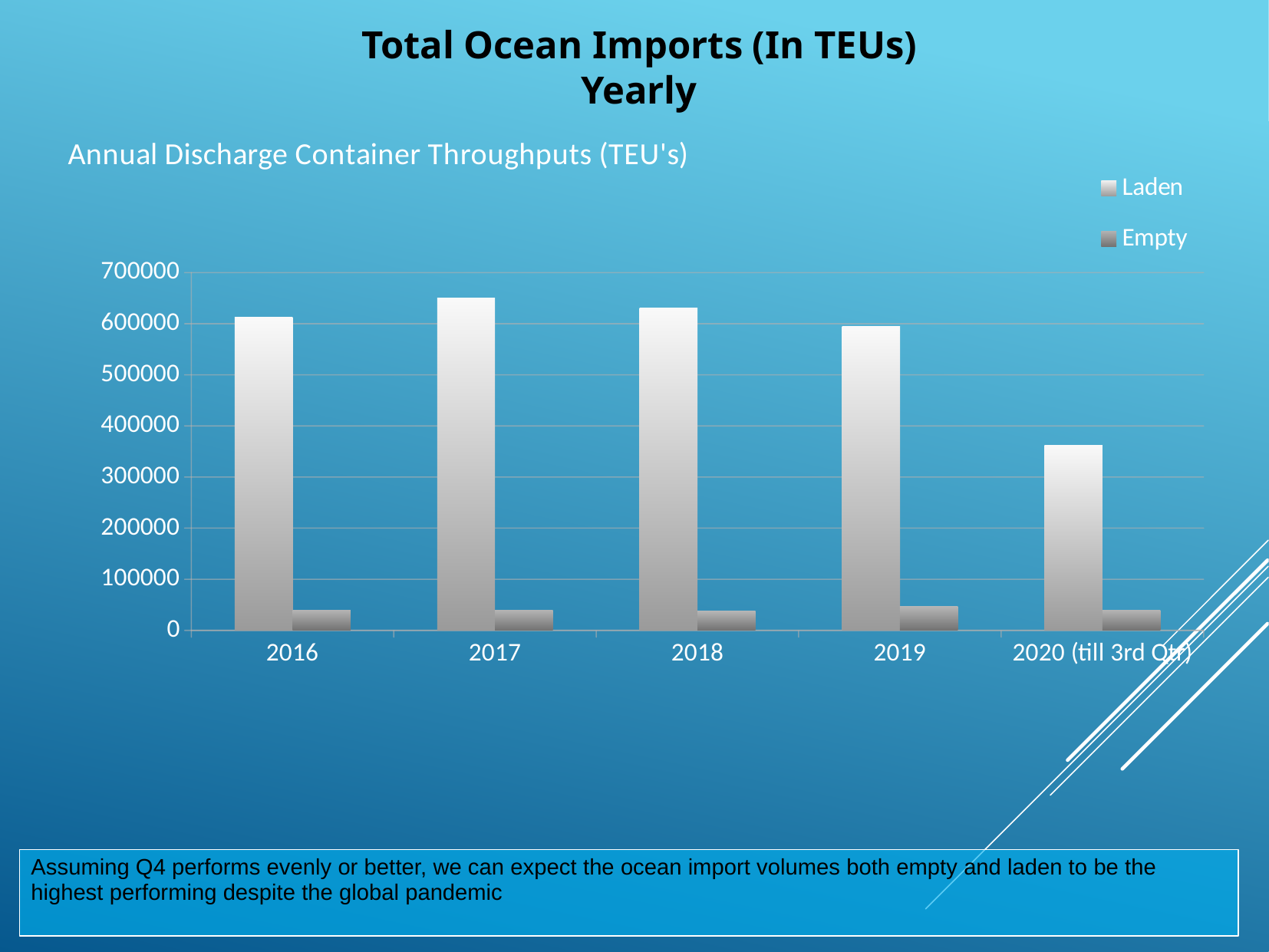
What kind of chart is shown on the slide? bar chart Which year has the highest Empty value? 2019 Is the Empty value for 2019 greater or less than 100000? less How many year categories are shown on the x axis? 5 How many series does the legend list? 2 Is the Laden value for 2020 (till 3rd Qtr) greater or less than 400000? less Which is larger, the Laden value for 2018 or the Laden value for 2020 (till 3rd Qtr)? 2018 Is the Laden value for 2017 greater or less than 600000? greater Do the Laden values rise or fall from 2017 to 2020 (till 3rd Qtr)? fall What is the title shown above the chart area? Annual Discharge Container Throughputs (TEU's) Which year has the lowest Laden value? 2020 (till 3rd Qtr) Which year has the highest Laden value? 2017